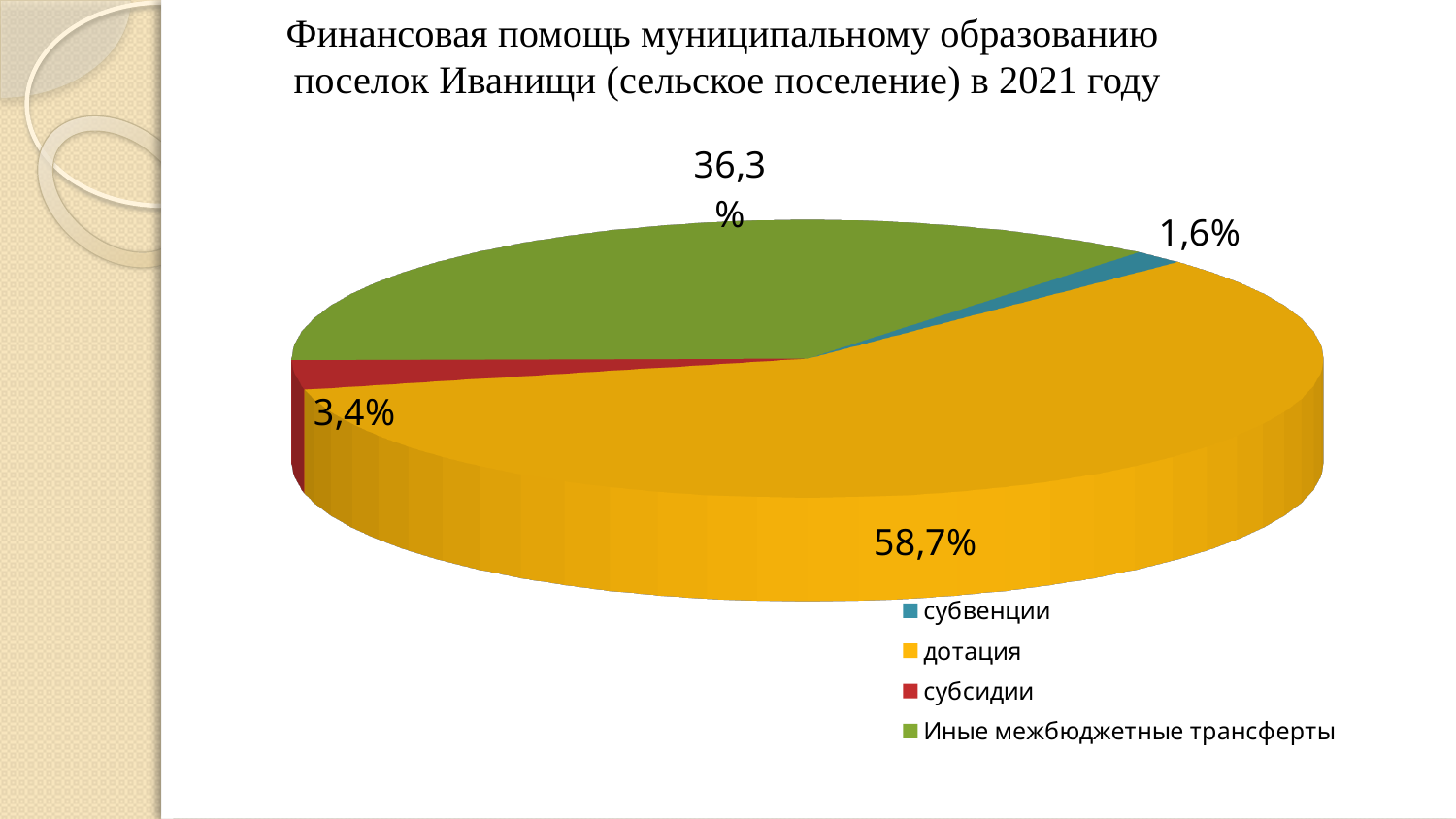
Which category has the smallest share of the pie? субвенции What is the value shown for субвенции? 1,6% Which is larger, the share for субсидии or the share for субвенции? субсидии What kind of chart is shown on the slide? pie chart Which category has the largest share of the pie? дотация What is the difference in percentage points between дотация and Иные межбюджетные трансферты? 22,4 What year does the chart title refer to? 2021 What share of the pie does дотация have? 58,7% How many slices does the pie chart have? 4 What colour is the slice for Иные межбюджетные трансферты? green What is the value shown for субсидии? 3,4% What share of the pie does Иные межбюджетные трансферты have? 36,3%